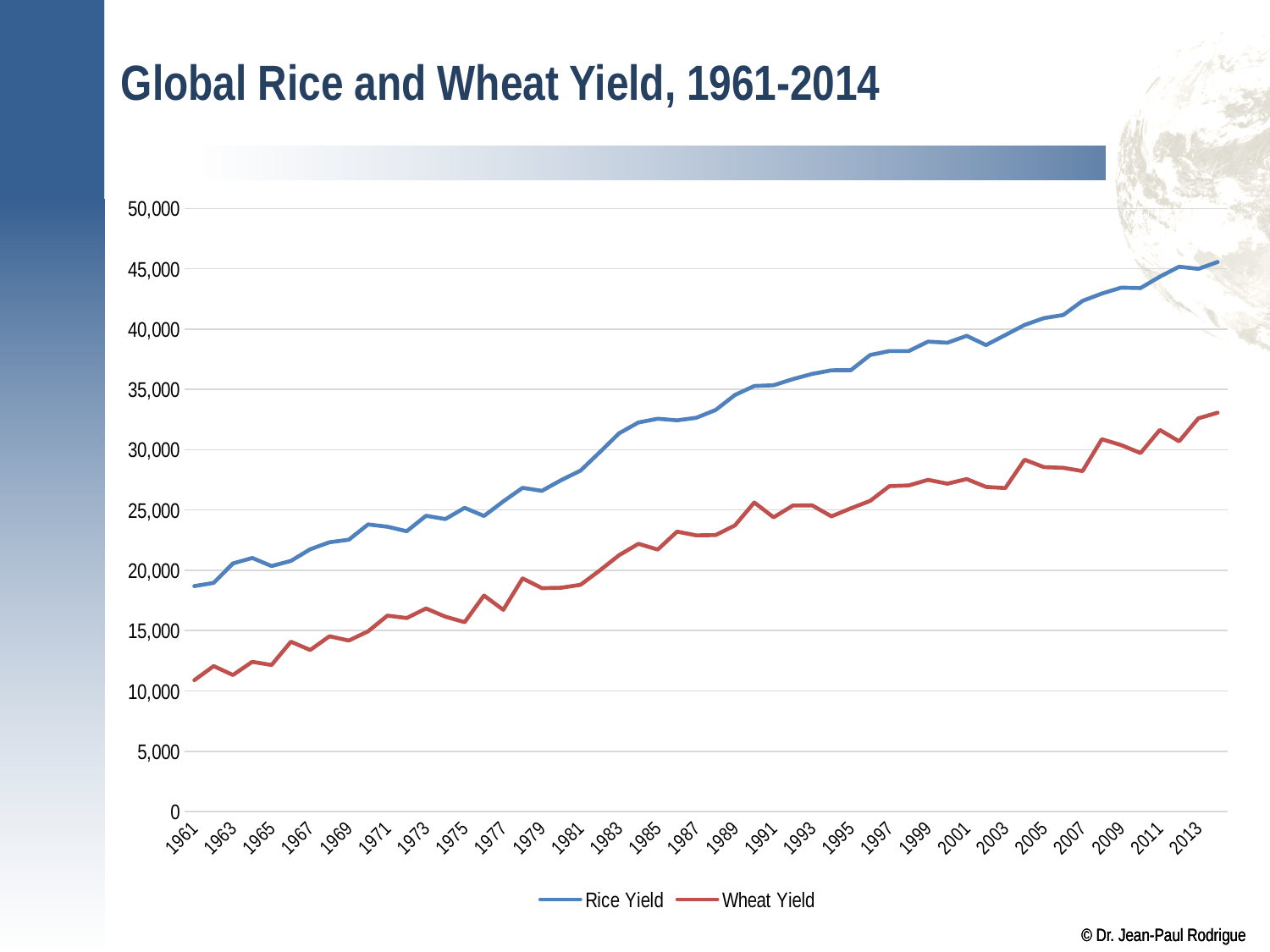
What is the title of the chart? Global Rice and Wheat Yield, 1961-2014 Does the Rice Yield line generally rise or fall from 1961 to 2014? rise Which series has the higher value in 1985, Rice Yield or Wheat Yield? Rice Yield Does the Wheat Yield line generally rise or fall across the years shown? rise How many series does the legend list? 2 Which series is drawn in red? Wheat Yield Is the Wheat Yield value for 2013 greater or less than 30,000? greater What kind of chart is shown on the slide? line chart Is the Rice Yield value for 1961 greater or less than 20,000? less Is the Wheat Yield value for 1961 greater or less than 10,000? greater In which year is the Rice Yield at its lowest? 1961